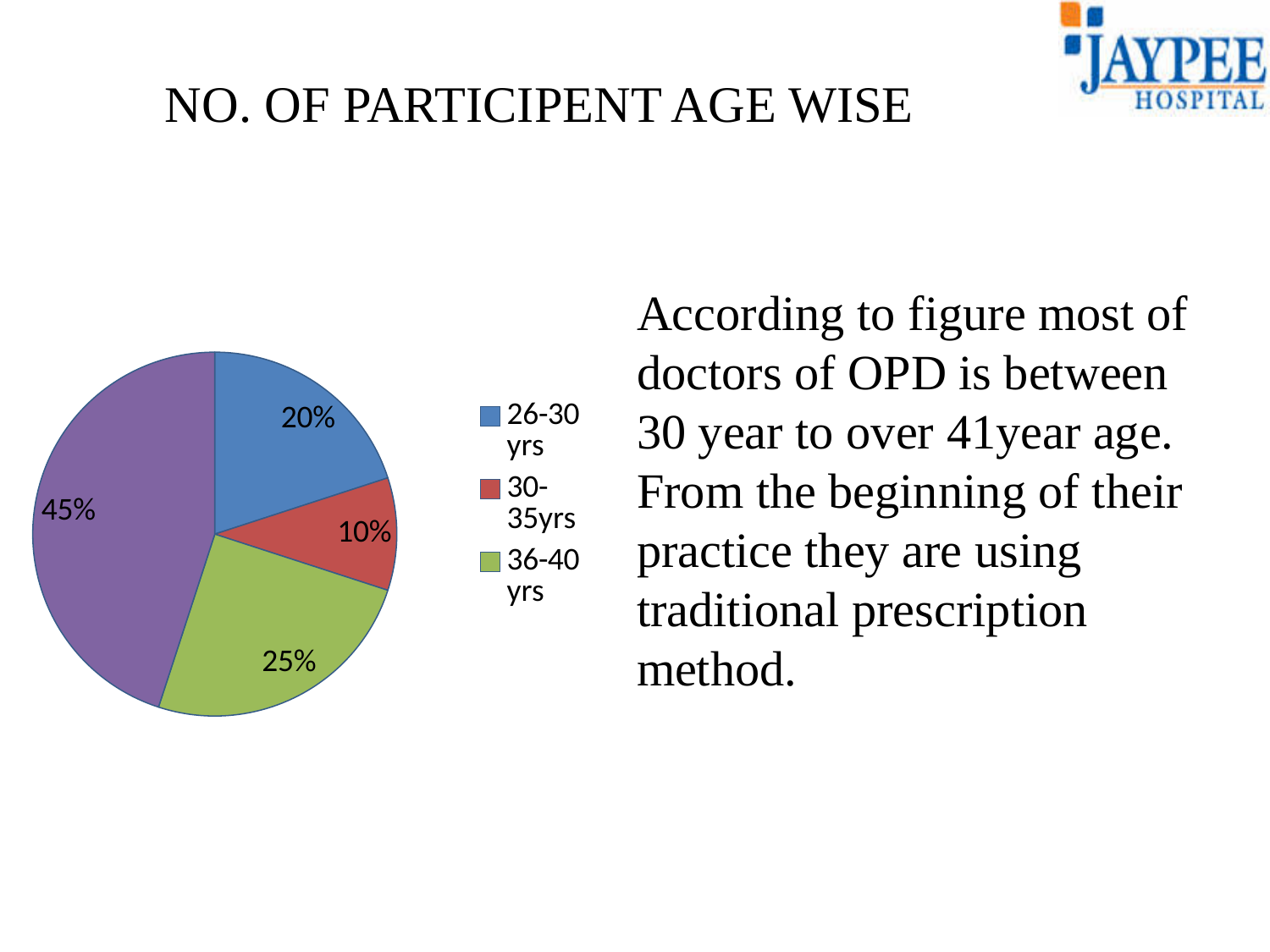
How many entries does the legend list? 3 Which of the labelled age groups in the legend has the smallest share of participants? 30-35yrs What is the difference in percentage points between the 36-40 yrs and 30-35yrs groups? 15 What is the title of the slide containing the pie chart? NO. OF PARTICIPENT AGE WISE How many slices does the pie chart have? 4 What type of chart is shown on the slide? pie chart What percentage of participants are in the 26-30 yrs age group? 20% Which of the legend age groups has the largest share: 26-30 yrs, 30-35yrs or 36-40 yrs? 36-40 yrs What percentage of participants are in the 36-40 yrs age group? 25% What percentage of participants are in the 30-35yrs age group? 10% What is the largest percentage shown on the pie chart? 45% Which is larger, the share for 26-30 yrs or the share for 30-35yrs? 26-30 yrs